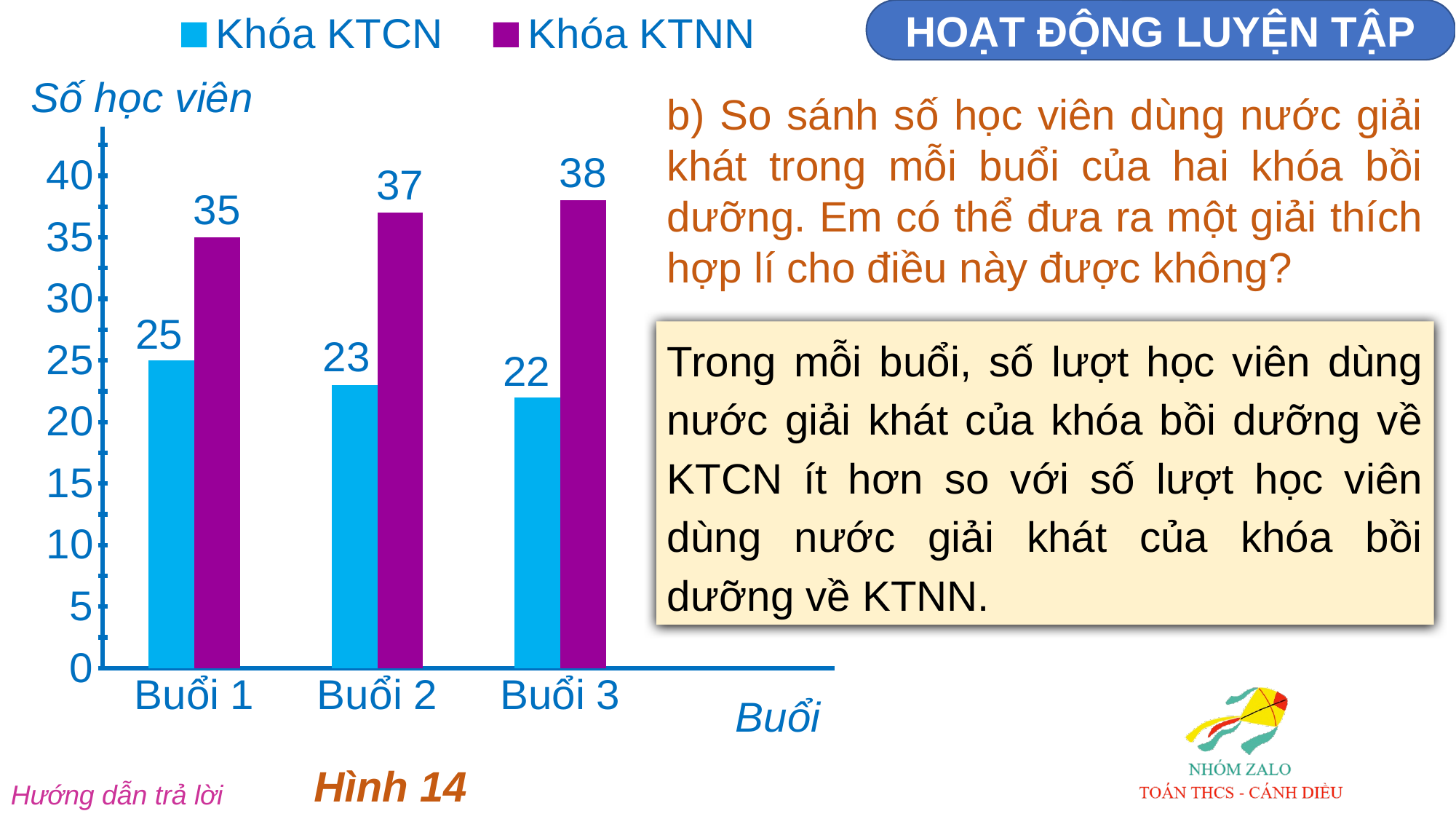
What is the value for Khóa KTCN in Buổi 1? 25 What is the difference between Khóa KTNN and Khóa KTCN in Buổi 3? 16 Do the values for Khóa KTCN rise or fall from Buổi 1 to Buổi 3? Fall What kind of chart is shown on the slide? Bar chart What is the value for Khóa KTNN in Buổi 3? 38 How many sessions (categories) are shown on the x axis? 3 How many series does the legend list? 2 Which session (Buổi) has the lowest value for Khóa KTCN? Buổi 3 In Buổi 2, which series has the larger value, Khóa KTCN or Khóa KTNN? Khóa KTNN What is the value for Khóa KTNN in Buổi 2? 37 Which session (Buổi) has the highest value for Khóa KTNN? Buổi 3 What is the difference between Khóa KTNN and Khóa KTCN in Buổi 1? 10